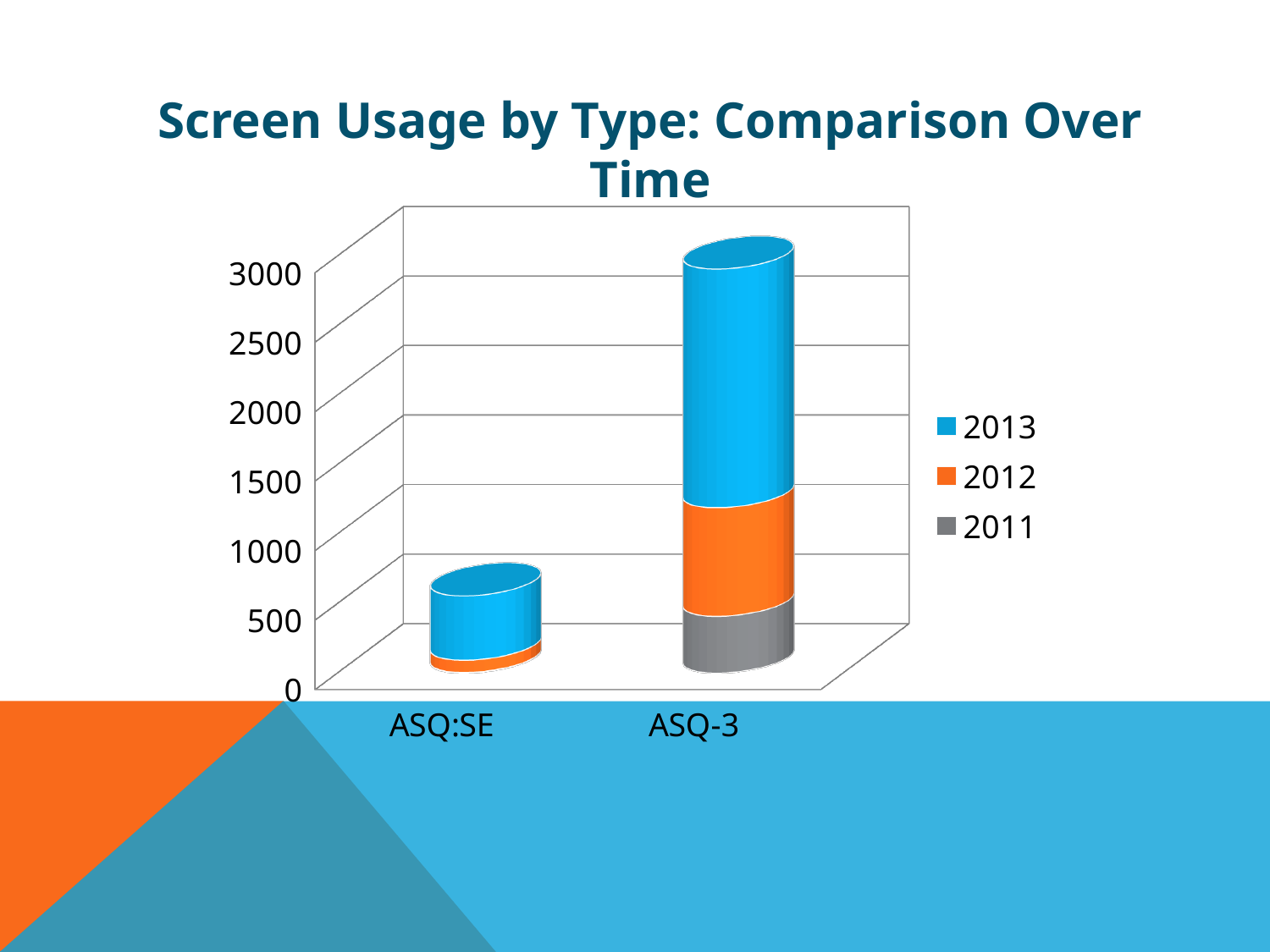
Is the total stacked value for ASQ:SE greater or less than 1000? less How many series does the legend list? 3 What is the title of the chart? Screen Usage by Type: Comparison Over Time How many categories are shown on the x axis? 2 Which years are listed in the legend? 2013, 2012, 2011 Which is larger, the total for ASQ-3 or the total for ASQ:SE? ASQ-3 Which category has the shorter stacked bar? ASQ:SE Which series makes up the largest part of the ASQ-3 bar? 2013 Which category has the taller stacked bar? ASQ-3 Is the total stacked value for ASQ-3 greater or less than 2500? greater What kind of chart is shown on the slide? bar chart